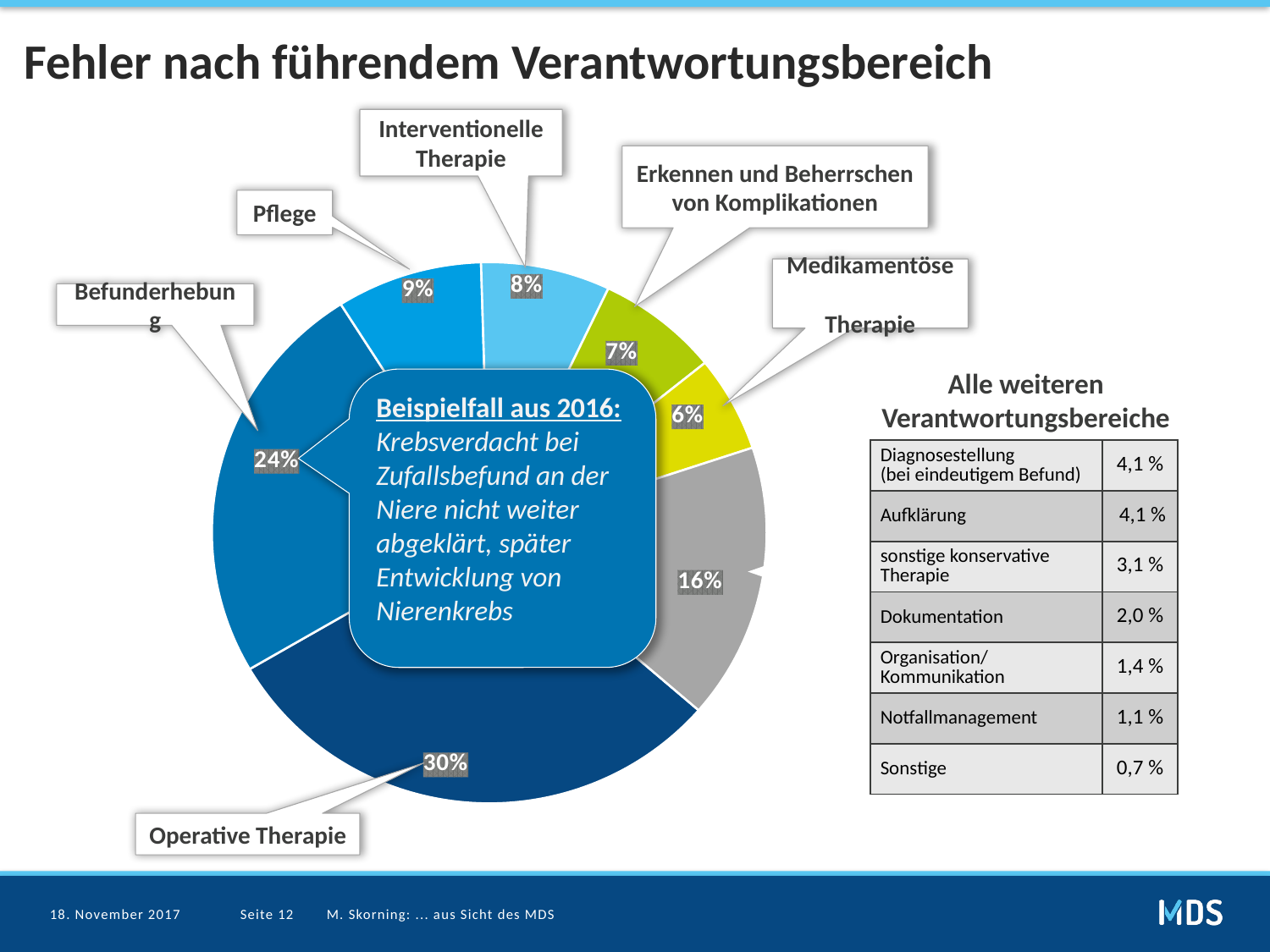
What share of errors is attributed to Interventionelle Therapie? 8% How many slices does the pie chart have? 7 What share of errors is attributed to Befunderhebung? 24% How many percentage points larger is the share for Operative Therapie than for Befunderhebung? 6 Which labelled area of responsibility has the largest share in the pie chart? Operative Therapie What share of errors is attributed to Pflege? 9% What share of errors is attributed to Medikamentöse Therapie? 6% What share of errors is attributed to Erkennen und Beherrschen von Komplikationen? 7% Which labelled area of responsibility has the smallest share in the pie chart? Medikamentöse Therapie Which has the larger share, Pflege or Interventionelle Therapie? Pflege What kind of chart is shown on the slide? pie chart What share of errors is attributed to Operative Therapie? 30%